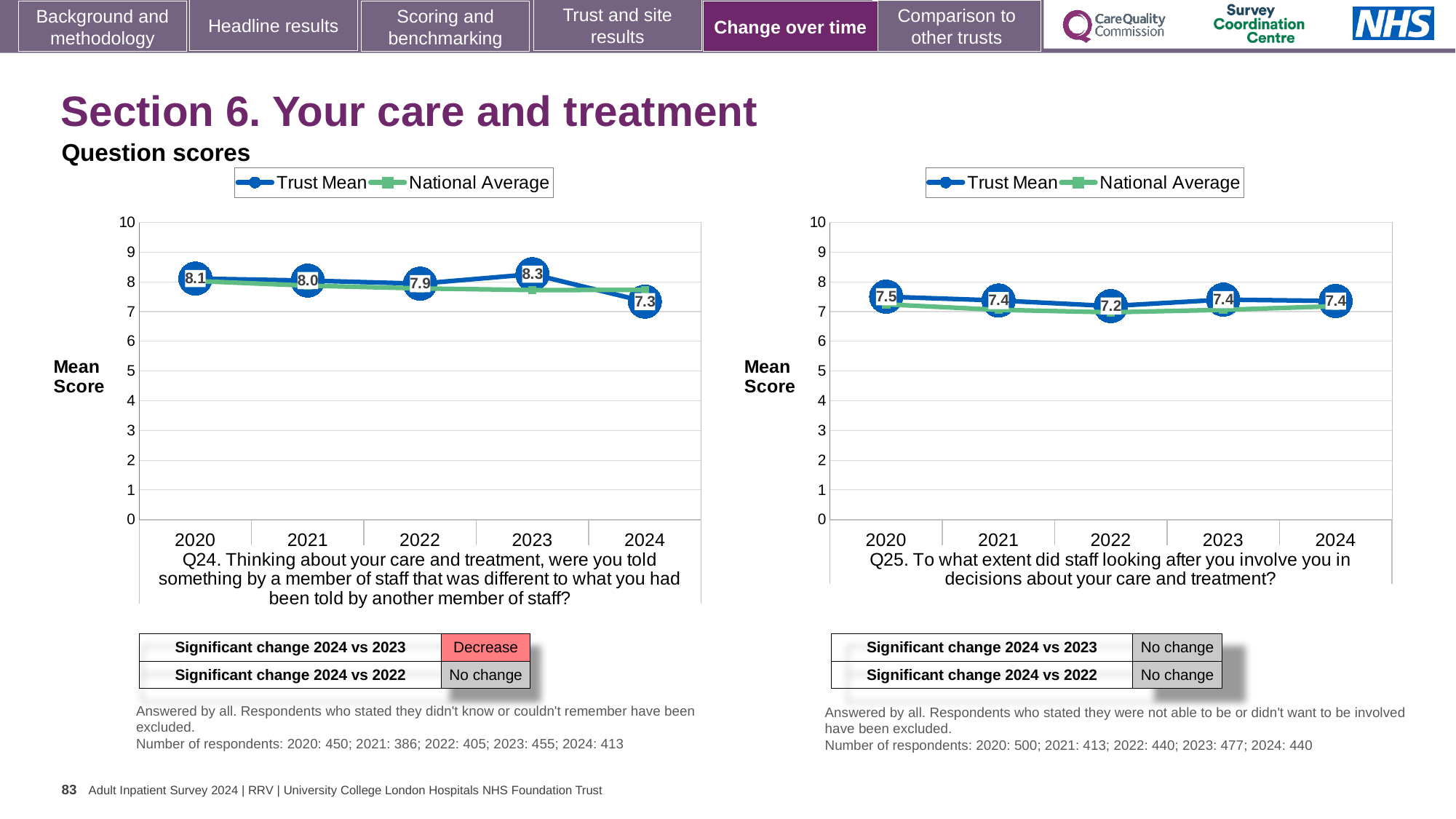
On the left chart (Q24), what is the difference between the Trust Mean scores for 2023 and 2024? 1.0 On the left chart (Q24), what is the Trust Mean score for 2023? 8.3 What type of chart is used for Q24 on the left? Line chart On the right chart (Q25), which year has the lowest Trust Mean score? 2022 On the right chart (Q25), is the Trust Mean score for 2020 greater or less than 7? greater On the left chart (Q24), which year has the highest Trust Mean score? 2023 On the left chart (Q24), which year has the lowest Trust Mean score? 2024 On the right chart (Q25), what is the Trust Mean score for 2020? 7.5 On the left chart (Q24), what is the Trust Mean score for 2024? 7.3 How many years are plotted on the left chart (Q24)? 5 On the right chart (Q25), what is the Trust Mean score for 2022? 7.2 How many series does the legend of the right chart (Q25) list? 2